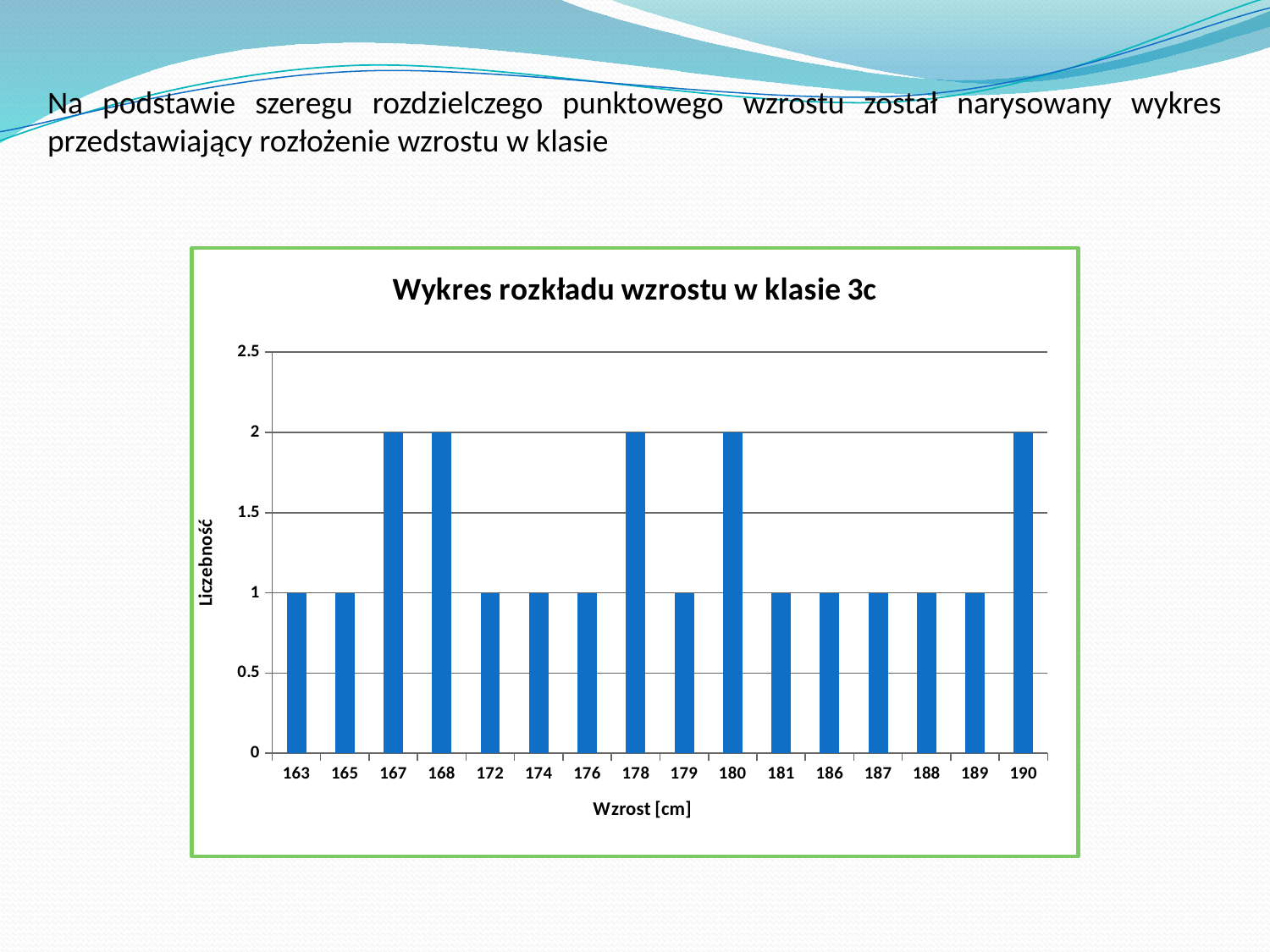
How many height categories are shown on the x axis of the chart? 16 What is the value (Liczebność) for the height 190 cm? 2 What is the difference between the value for 180 cm and the value for 181 cm? 1 What is the value (Liczebność) for the height 172 cm? 1 Which is larger, the value for 178 cm or the value for 179 cm? 178 cm What is the label of the x axis of the chart? Wzrost [cm] How many height categories have a value of 2? 5 What type of chart is shown on the slide? bar chart What is the value (Liczebność) for the height 186 cm? 1 Is the value for 168 cm greater or less than 1.5? greater What is the value (Liczebność) for the height 167 cm? 2 What is the title of the chart? Wykres rozkładu wzrostu w klasie 3c